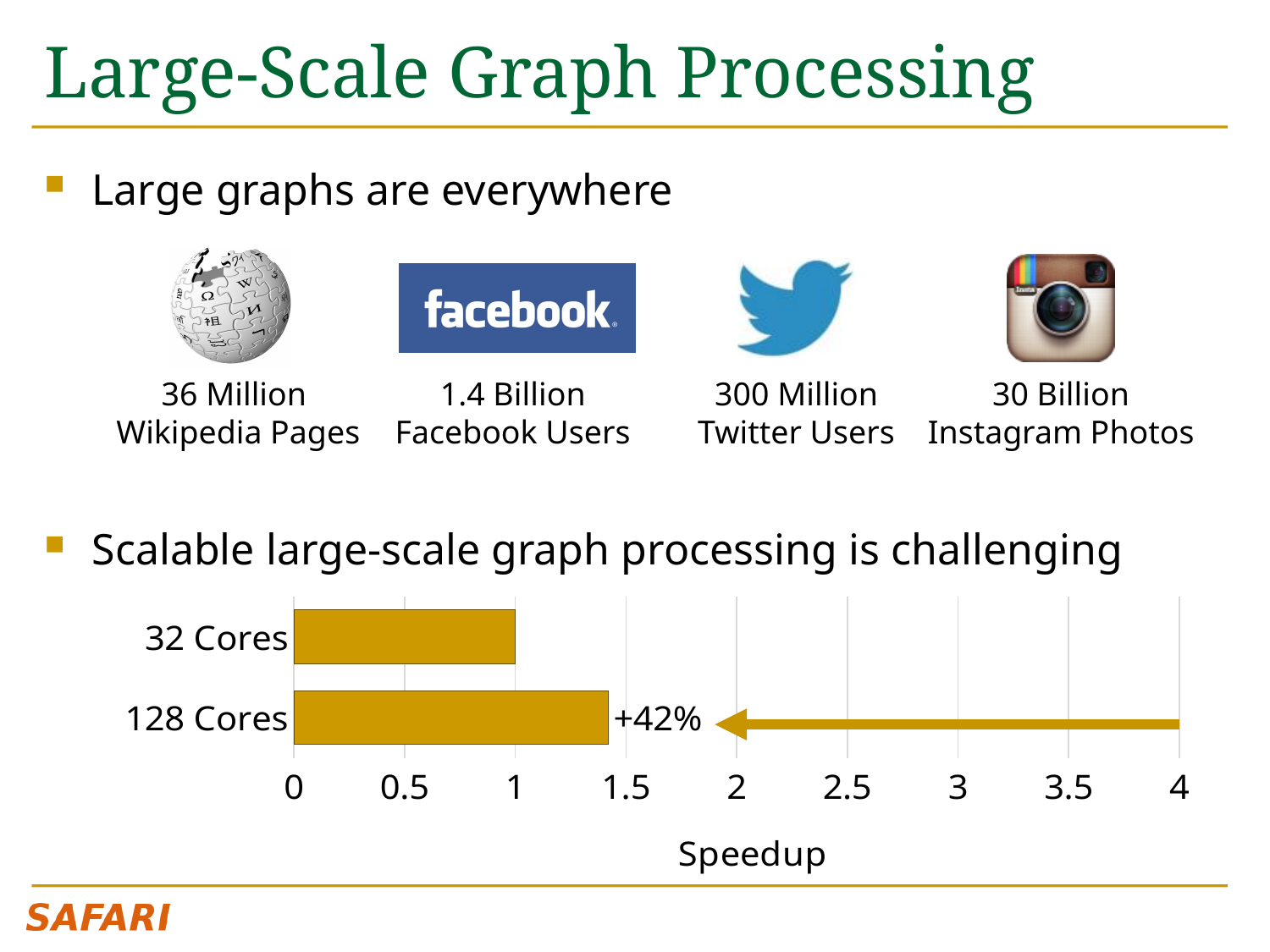
Is the speedup for 128 Cores greater or less than 1.5? less How many categories does the bar chart show? 2 What percentage improvement is annotated next to the 128 Cores bar? +42% Which category has the lowest speedup? 32 Cores What is the maximum value shown on the x axis of the bar chart? 4 Which category has the higher speedup, 32 Cores or 128 Cores? 128 Cores What is the label of the x axis of the bar chart? Speedup What is the speedup value for 32 Cores? 1 Is the speedup for 128 Cores greater or less than 1? greater What kind of chart is shown on the slide? bar chart Which category has the highest speedup? 128 Cores